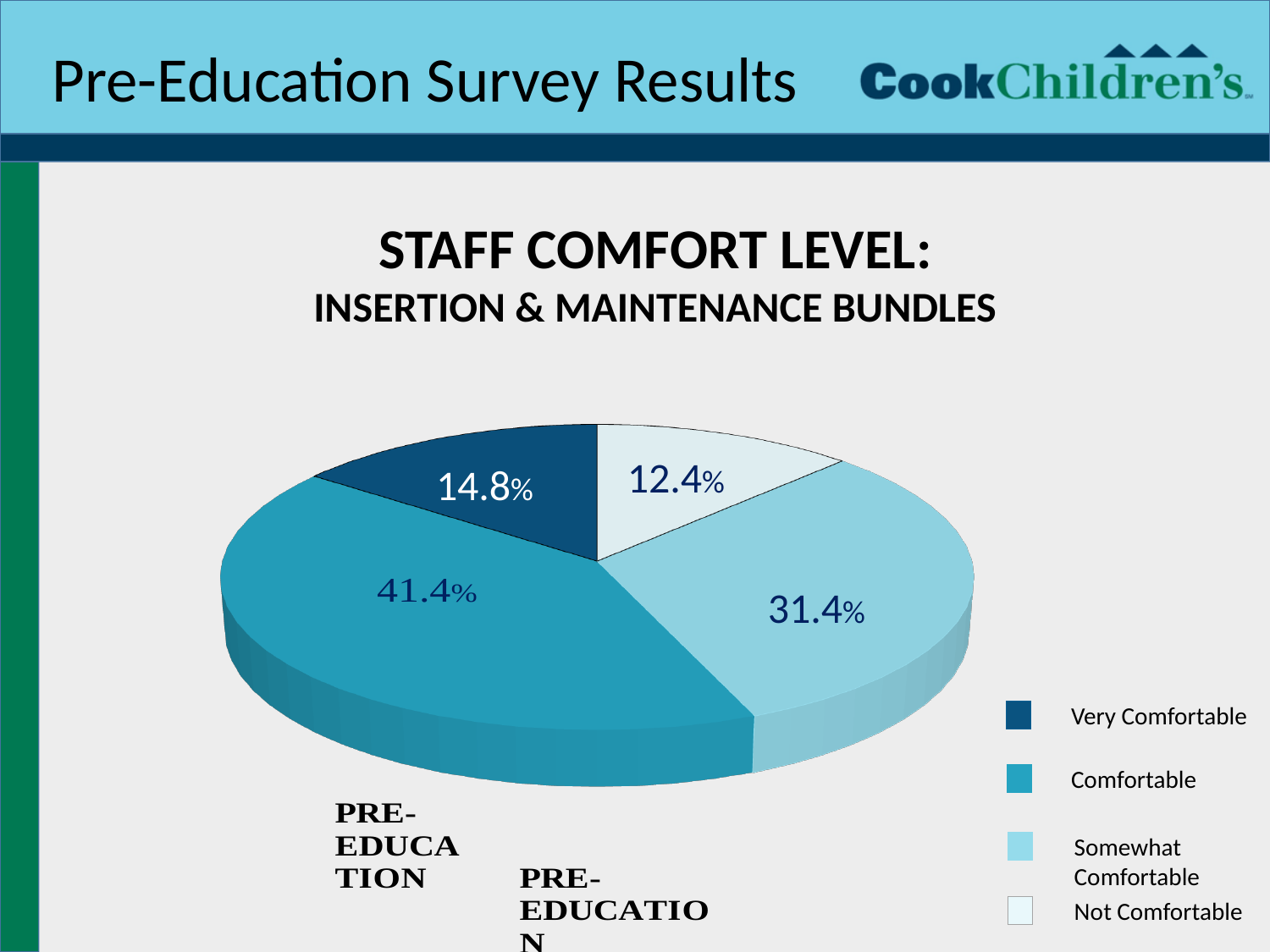
Which is larger, the Very Comfortable slice or the Not Comfortable slice? Very Comfortable What percentage of staff reported being Very Comfortable? 14.8% Which comfort level has the largest share of the pie? Comfortable What is the title of the chart? Staff Comfort Level: Insertion & Maintenance Bundles How many slices does the pie chart have? 4 What kind of chart is shown on the slide? Pie chart Which comfort level has the smallest share of the pie? Not Comfortable What is the difference in percentage points between the Comfortable and Somewhat Comfortable slices? 10 percentage points What percentage of staff reported being Comfortable? 41.4% What percentage of staff reported being Not Comfortable? 12.4% What percentage of staff reported being Somewhat Comfortable? 31.4% How many entries does the legend list? 4